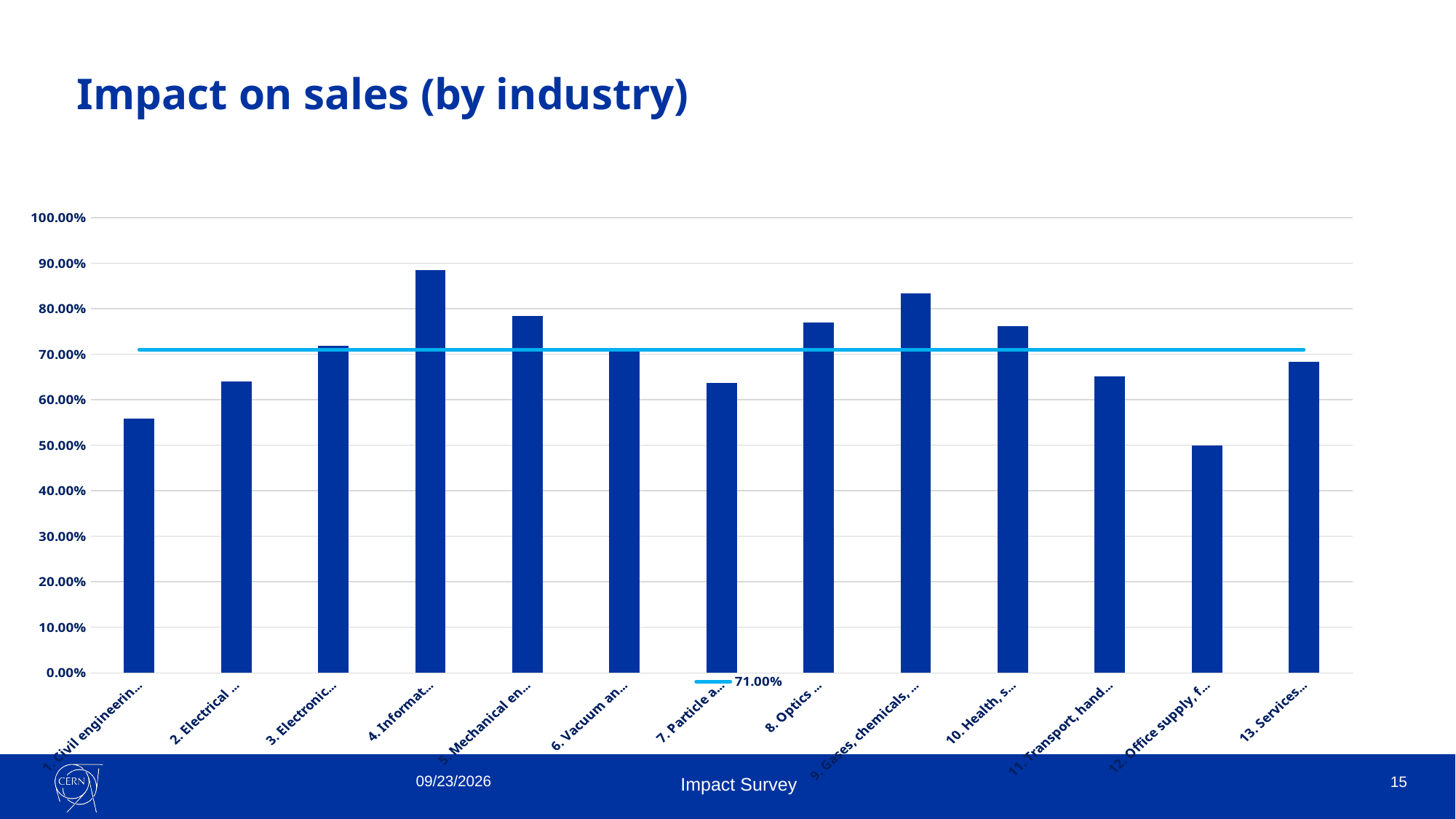
Is the value for "13. Services..." greater or less than 70.00%? less Which has the larger value, "4. Informat..." or "9. Gases, chemicals, ..."? 4. Informat... Which has the larger value, "10. Health, s..." or "11. Transport, hand..."? 10. Health, s... Which industry category has the lowest bar? 12. Office supply, f... Is the value for "9. Gases, chemicals, ..." greater or less than 80.00%? greater Is the value for "1. Civil engineerin..." greater or less than 60.00%? less What kind of chart is shown on the slide? bar chart Which industry category has the highest bar? 4. Informat... How many industry categories are plotted along the x axis? 13 What is the title of the chart on the slide? Impact on sales (by industry) What value is shown in the legend for the horizontal line across the chart? 71.00%